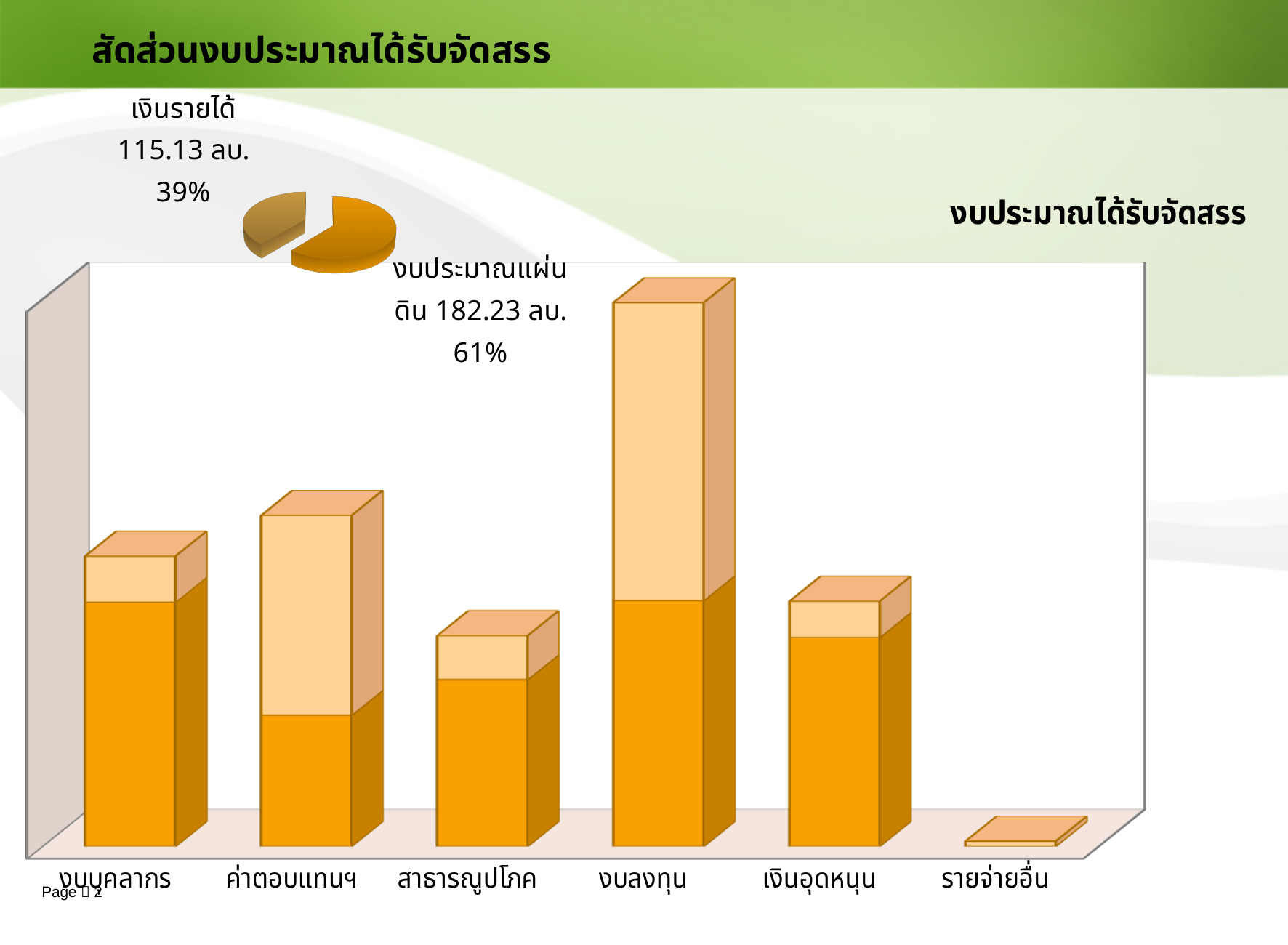
In the chart titled งบประมาณได้รับจัดสรร, which category has the tallest bar? งบลงทุน In the pie chart at the top left, what is the value shown for งบประมาณแผ่นดิน? 182.23 ลบ. In the pie chart at the top left, how many slices are there? 2 In the chart titled งบประมาณได้รับจัดสรร, how many categories are shown on the x axis? 6 What kind of chart is the chart titled งบประมาณได้รับจัดสรร? Stacked bar chart In the pie chart at the top left, what share of the budget is งบประมาณแผ่นดิน? 61% In the pie chart at the top left, what is the value shown for เงินรายได้? 115.13 ลบ. In the chart titled งบประมาณได้รับจัดสรร, which category has the shortest bar? รายจ่ายอื่น In the pie chart at the top left, by how many percentage points does งบประมาณแผ่นดิน exceed เงินรายได้? 22 In the chart titled งบประมาณได้รับจัดสรร, which bar is taller, งบบุคลากร or ค่าตอบแทนฯ? ค่าตอบแทนฯ In the pie chart at the top left, which slice is larger, เงินรายได้ or งบประมาณแผ่นดิน? งบประมาณแผ่นดิน In the pie chart at the top left, what share of the budget is เงินรายได้? 39%